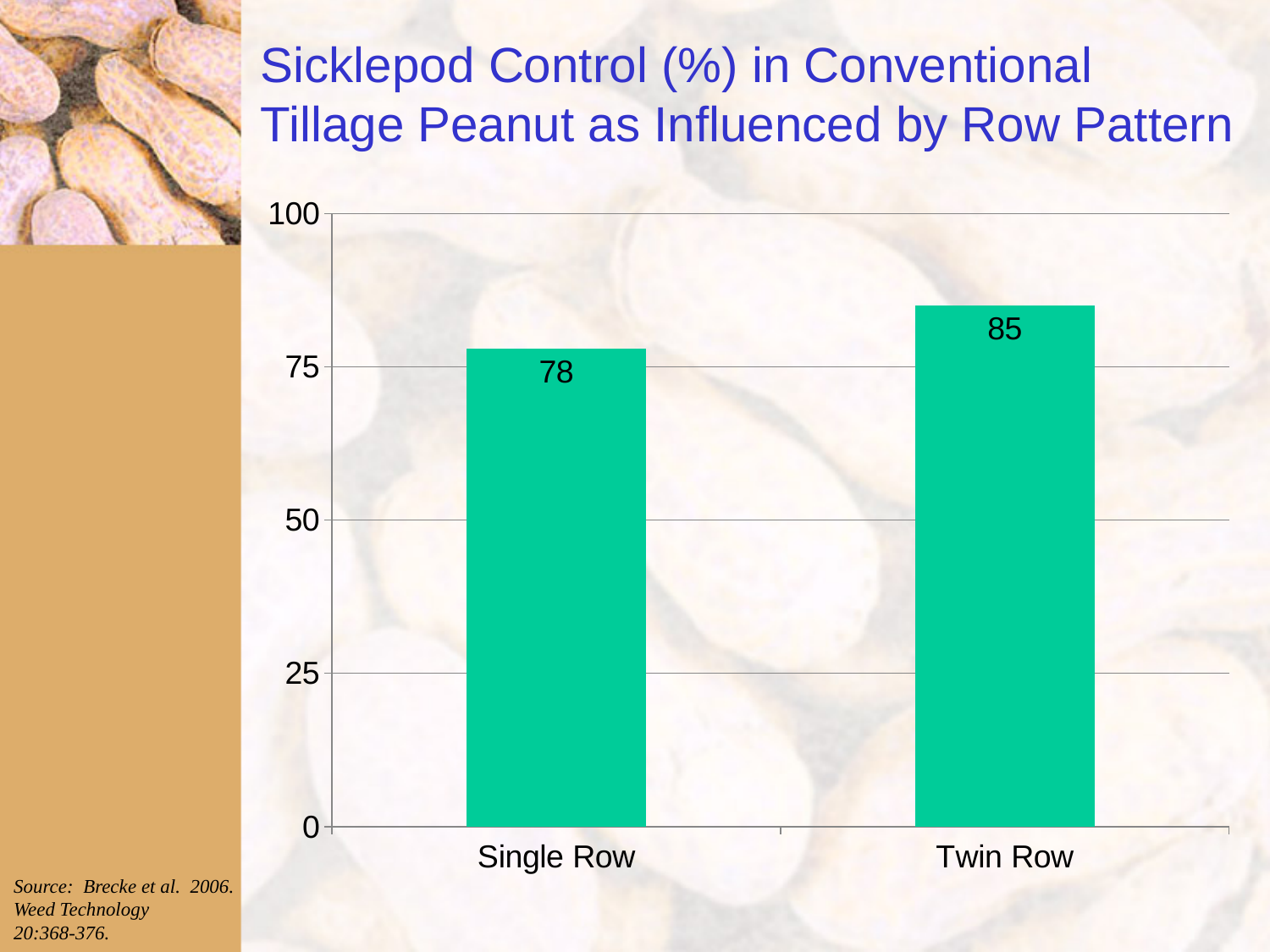
What is the sicklepod control value for Single Row? 78 Is the value for Twin Row greater or less than 100? less Is the value for Single Row greater or less than 75? greater How many row patterns are shown on the chart? 2 Which row pattern has the lowest sicklepod control? Single Row What is the difference in sicklepod control between Twin Row and Single Row? 7 What is the title of the chart? Sicklepod Control (%) in Conventional Tillage Peanut as Influenced by Row Pattern What kind of chart is shown on the slide? bar chart Which row pattern has the highest sicklepod control? Twin Row What is the sicklepod control value for Twin Row? 85 What is the maximum value shown on the vertical axis? 100 Which has a larger sicklepod control value, Single Row or Twin Row? Twin Row